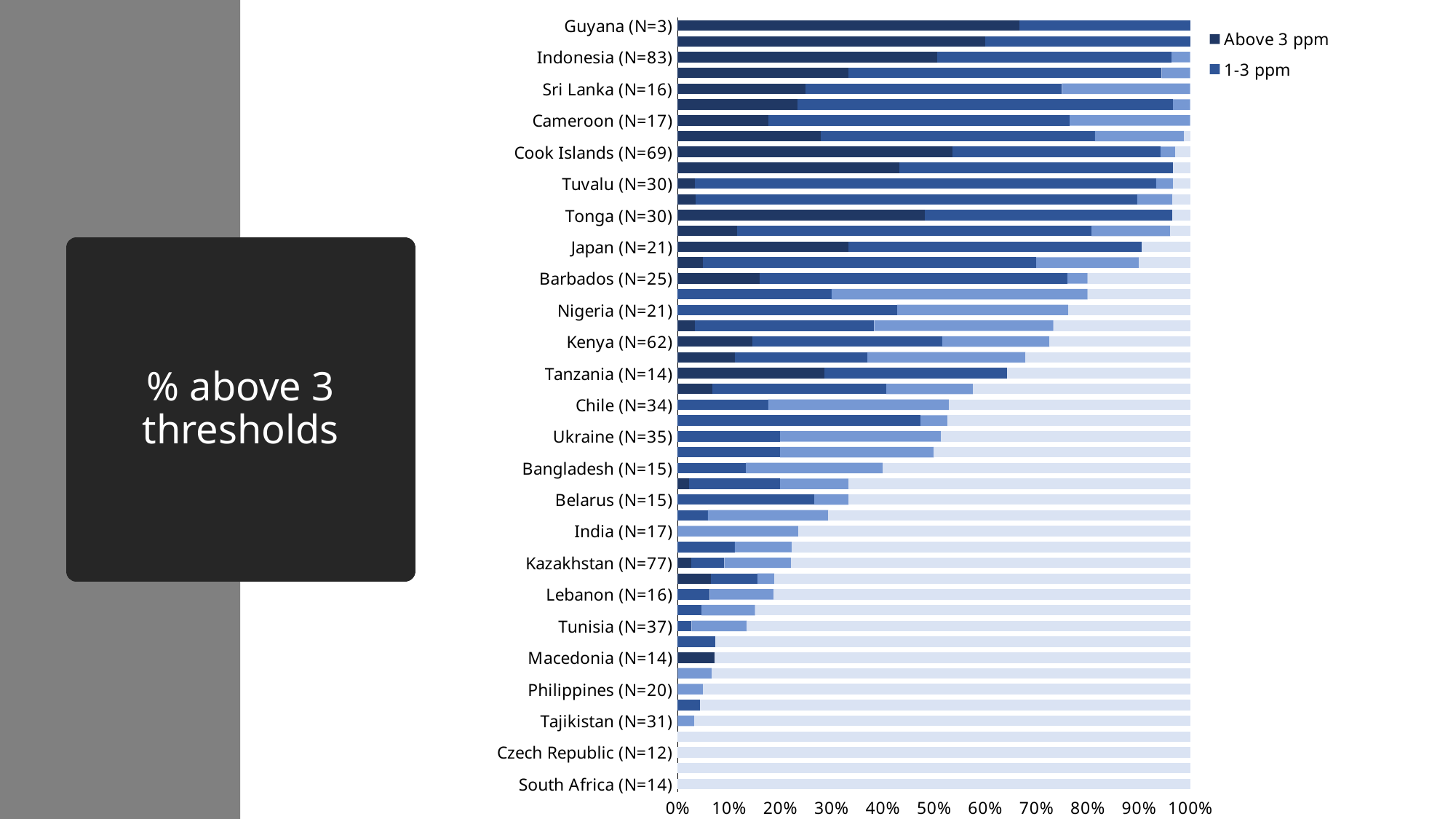
What are the two series named in the chart legend? Above 3 ppm and 1-3 ppm Is the Above 3 ppm value for Tuvalu (N=30) greater or less than 10%? less What kind of chart is shown on the slide? Stacked bar chart Is the Above 3 ppm value for Kenya (N=62) greater or less than 20%? less How many series does the chart legend list? 2 Do the combined Above 3 ppm and 1-3 ppm shares rise or fall moving down the chart from Guyana to South Africa? fall Is the Above 3 ppm value for Guyana (N=3) greater or less than 60%? greater Which has the larger Above 3 ppm value, Guyana (N=3) or Sri Lanka (N=16)? Guyana (N=3) What is the title shown on the slide next to the chart? % above 3 thresholds Which labelled country has the highest Above 3 ppm value? Guyana (N=3)